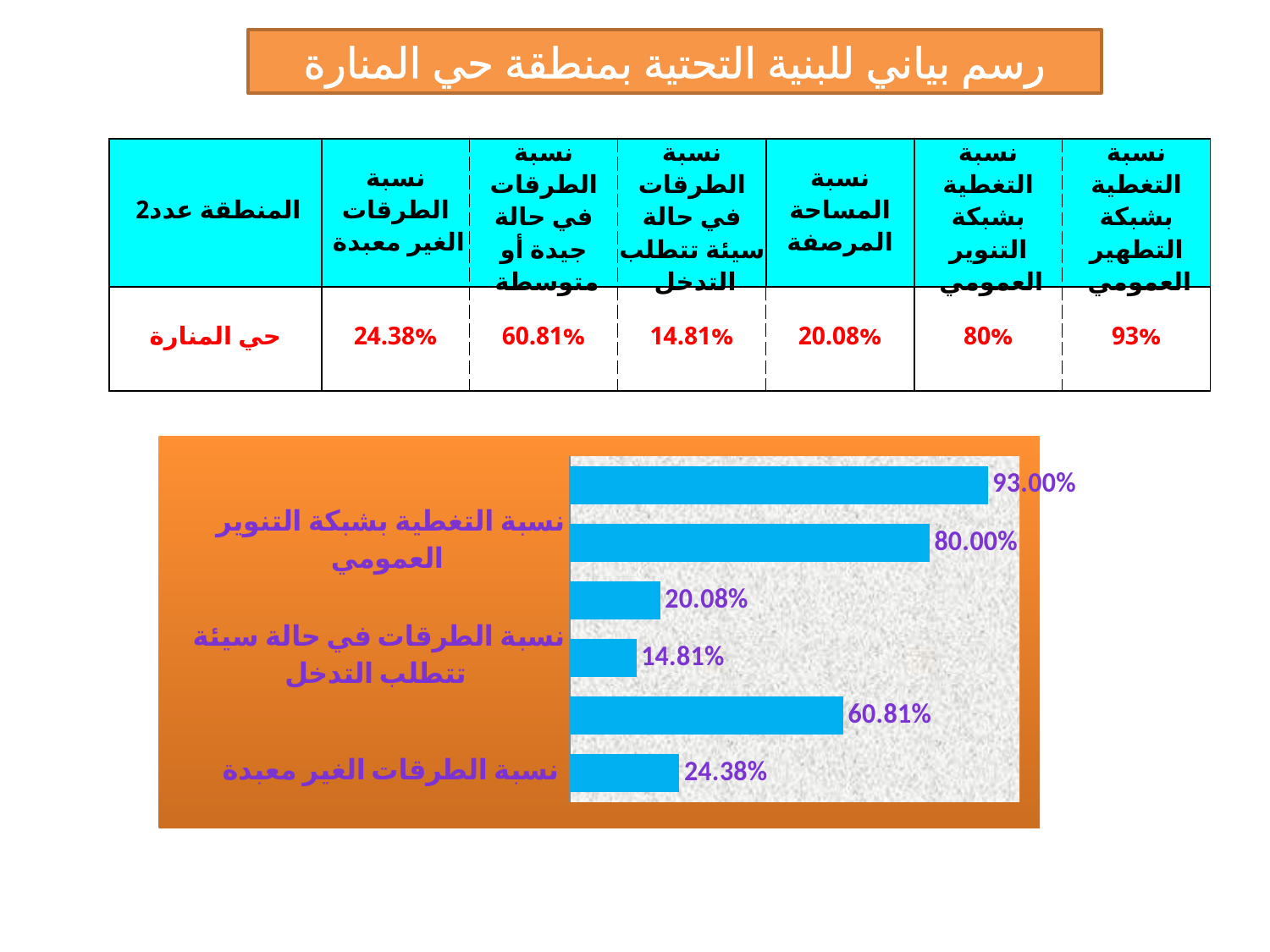
What is the value of the bar for نسبة التغطية بشبكة التنوير العمومي? 80.00% What is the lowest value shown in the chart? 14.81% Which category has the lowest value in the chart? نسبة الطرقات في حالة سيئة تتطلب التدخل What is the value of the bar for نسبة الطرقات في حالة سيئة تتطلب التدخل? 14.81% What is the highest value shown in the chart? 93.00% What type of chart is shown on the slide? bar chart What is the value of the bar for نسبة الطرقات الغير معبدة? 24.38% How many bars are plotted in the chart? 6 What colour are the bars in the chart? blue What is the difference between the value for نسبة الطرقات الغير معبدة and the value for نسبة الطرقات في حالة سيئة تتطلب التدخل? 9.57% What is the difference between the value for نسبة التغطية بشبكة التنوير العمومي and the value for نسبة الطرقات الغير معبدة? 55.62% Which is larger: the bar for نسبة التغطية بشبكة التنوير العمومي or the bar for نسبة الطرقات الغير معبدة? نسبة التغطية بشبكة التنوير العمومي